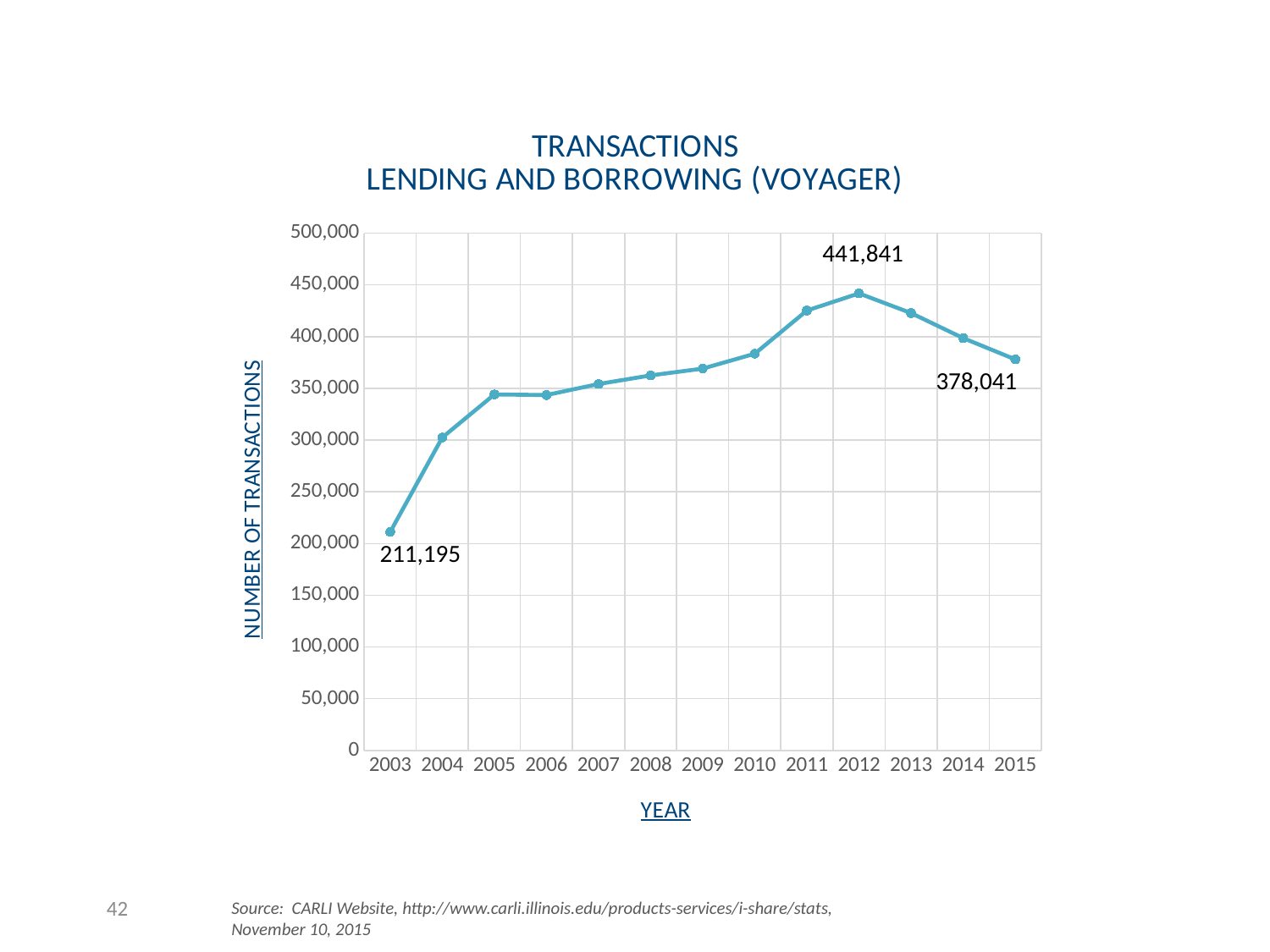
Do the values rise or fall from 2012 to 2015? fall What is the number of transactions in 2015? 378,041 Which year has the lowest number of transactions? 2003 What is the difference between the number of transactions in 2012 and in 2015? 63,800 Is the number of transactions in 2004 greater or less than 350,000? less What is the number of transactions in 2012? 441,841 What is the number of transactions in 2003? 211,195 Which year has more transactions, 2004 or 2010? 2010 How many years are plotted on the x axis? 13 Which year has the highest number of transactions? 2012 What is the difference between the number of transactions in 2012 and in 2003? 230,646 What kind of chart is shown on the slide? line chart